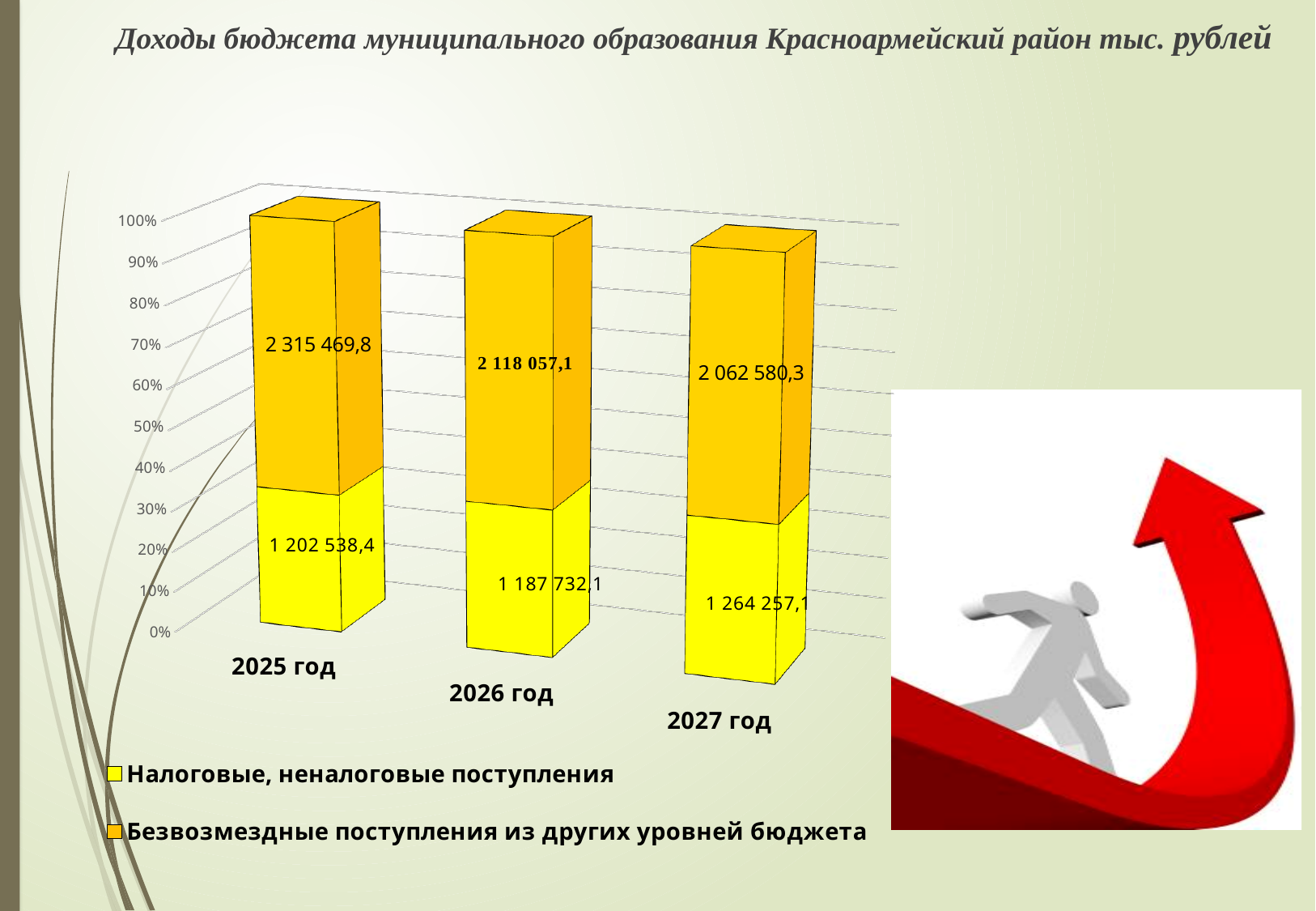
What is the value for Налоговые, неналоговые поступления in 2025 год? 1 202 538,4 How many series does the legend list? 2 What kind of chart is shown on the slide? Stacked bar chart In which year is the value for Налоговые, неналоговые поступления the lowest? 2026 год Which is larger: Налоговые, неналоговые поступления in 2027 год or in 2026 год? 2027 год What is the total of the two values in the 2025 год bar? 3 518 008,2 In which year is the value for Безвозмездные поступления из других уровней бюджета the highest? 2025 год What is the difference between the Безвозмездные поступления из других уровней бюджета values for 2025 год and 2026 год? 197 412,7 Do the values for Безвозмездные поступления из других уровней бюджета rise or fall from 2025 год to 2027 год? Fall How many years are shown on the x axis of the chart? 3 What is the value for Безвозмездные поступления из других уровней бюджета in 2027 год? 2 062 580,3 What is the value for Безвозмездные поступления из других уровней бюджета in 2026 год? 2 118 057,1